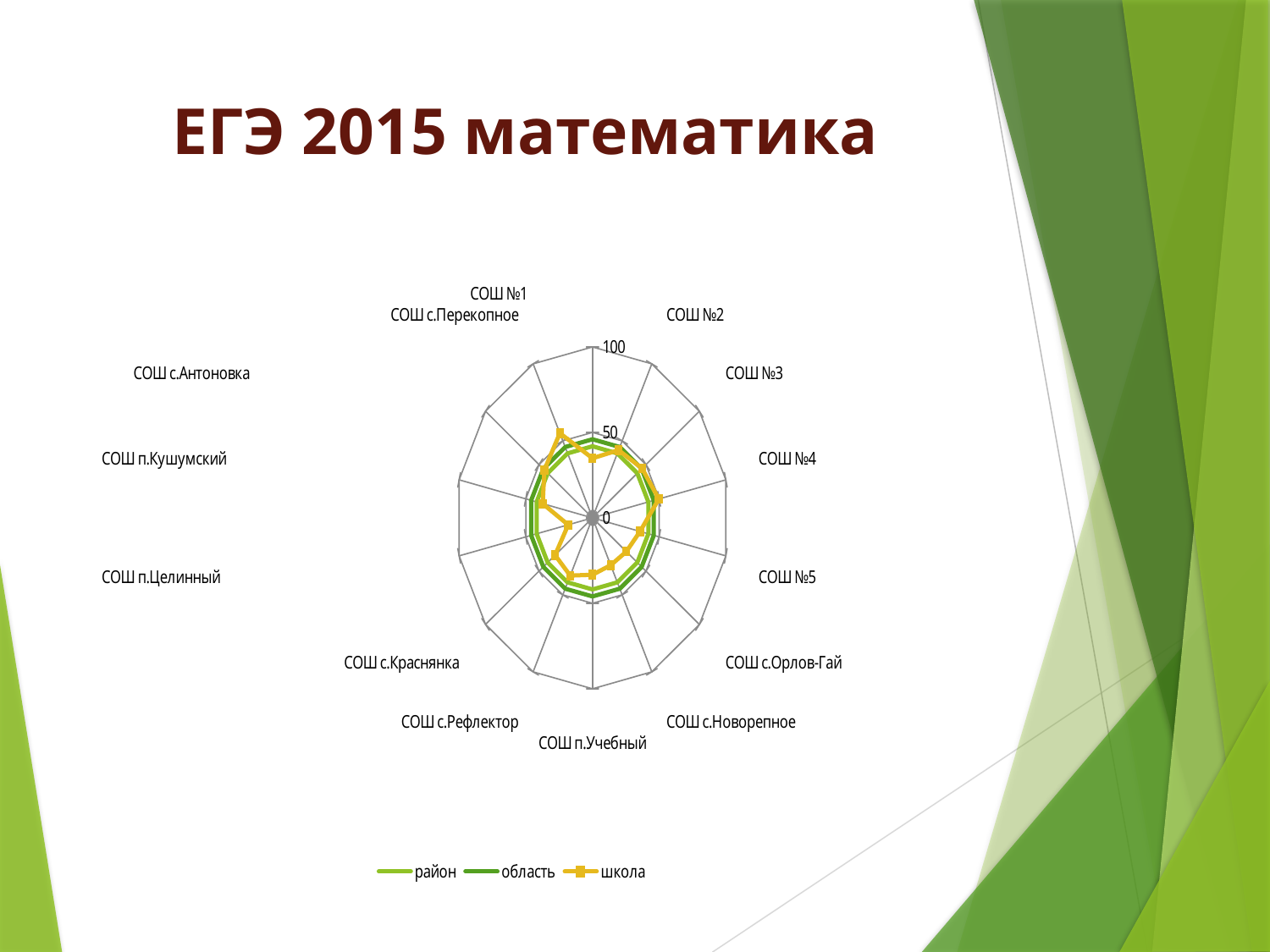
What are the three series named in the legend? район, область, школа What kind of chart is shown on the slide? radar chart Is the школа value for СОШ п.Целинный greater or less than 50? less Is the школа value for СОШ №1 greater or less than 50? less For СОШ п.Целинный, which series has the larger value: школа or область? область How many series does the legend list? 3 Is the район value for СОШ с.Рефлектор greater or less than 100? less What is the title of the slide above the chart? ЕГЭ 2015 математика How many schools (categories) are plotted on the radar chart? 14 For СОШ №1, which series has the larger value: школа or область? область